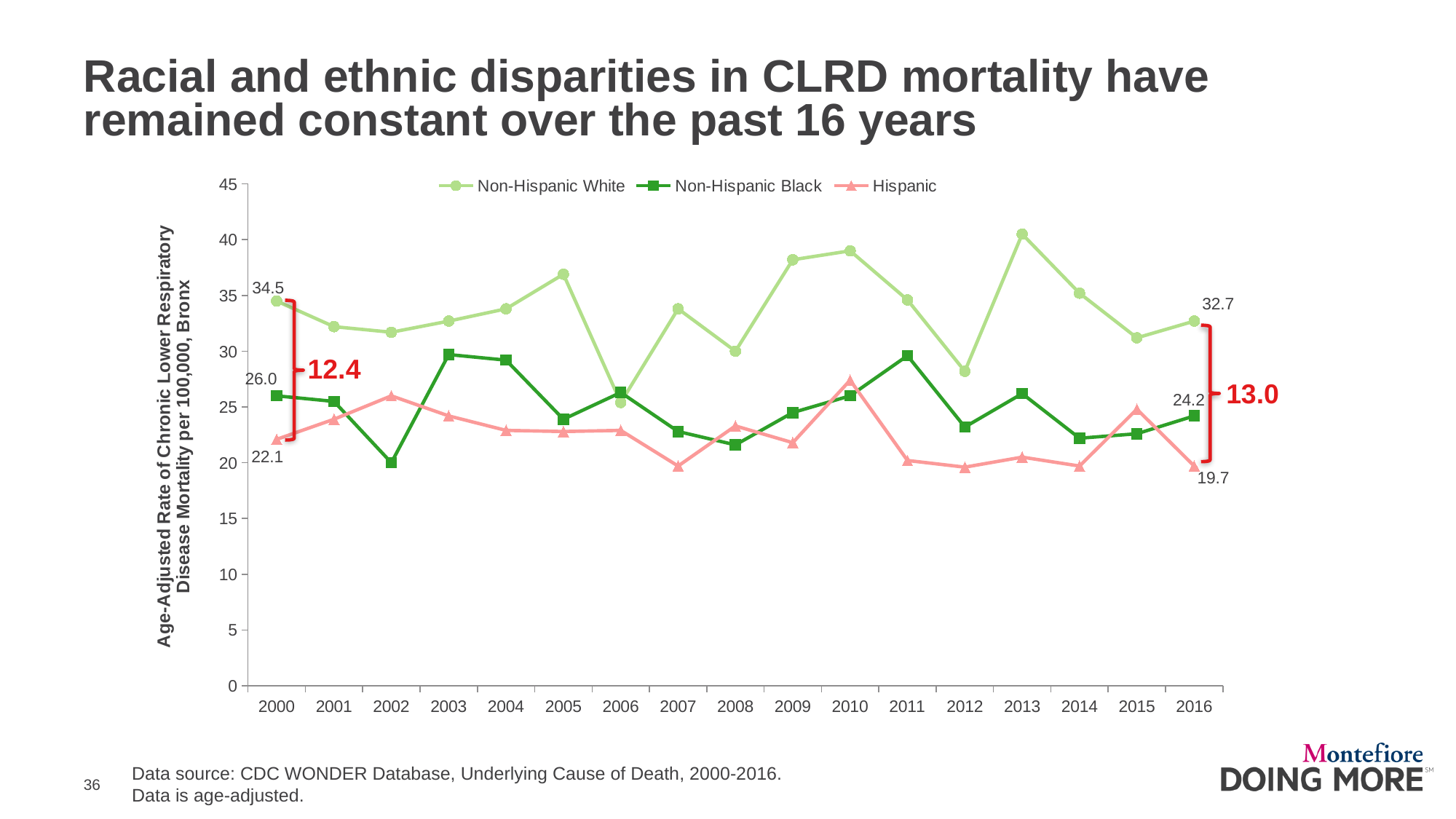
What is the value for Hispanic in 2016? 19.7 How many series does the legend list? 3 What is the value for Non-Hispanic White in 2000? 34.5 Which series has the lowest value in 2016? Hispanic What is the difference between the Non-Hispanic White and Hispanic values in 2016? 13.0 In which year does the Non-Hispanic White series reach its highest value? 2013 Is the value for Non-Hispanic White in 2012 greater or less than 30? less What is the difference between the Non-Hispanic White and Non-Hispanic Black values in 2000? 8.5 What is the value for Non-Hispanic Black in 2016? 24.2 Which is larger in 2000, the Non-Hispanic Black value or the Hispanic value? Non-Hispanic Black What kind of chart is shown on the slide? line chart How many years are plotted on the x axis? 17